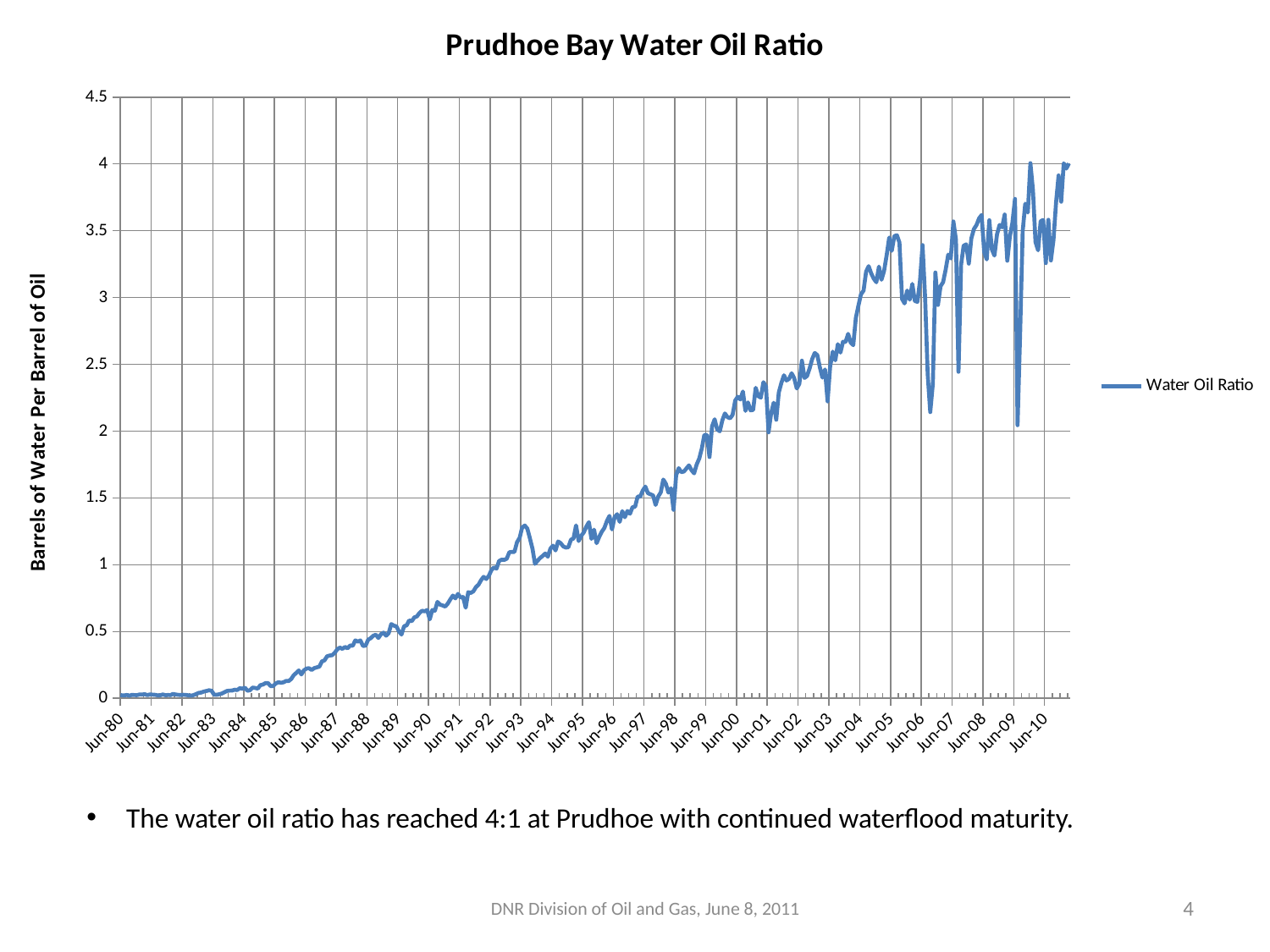
What is the label on the vertical axis of the chart? Barrels of Water Per Barrel of Oil Does the water oil ratio generally rise or fall from Jun-80 to Jun-10? rise What kind of chart is shown on the slide? line chart How many series does the legend list? 1 Which has the larger water oil ratio, Jun-85 or Jun-05? Jun-05 Is the water oil ratio at Jun-93 greater or less than 1? greater Is the water oil ratio at Jun-00 greater or less than 2? greater Is the water oil ratio at Jun-80 greater or less than 0.5? less Which has the larger water oil ratio, Jun-90 or Jun-97? Jun-97 What is the title of the chart? Prudhoe Bay Water Oil Ratio